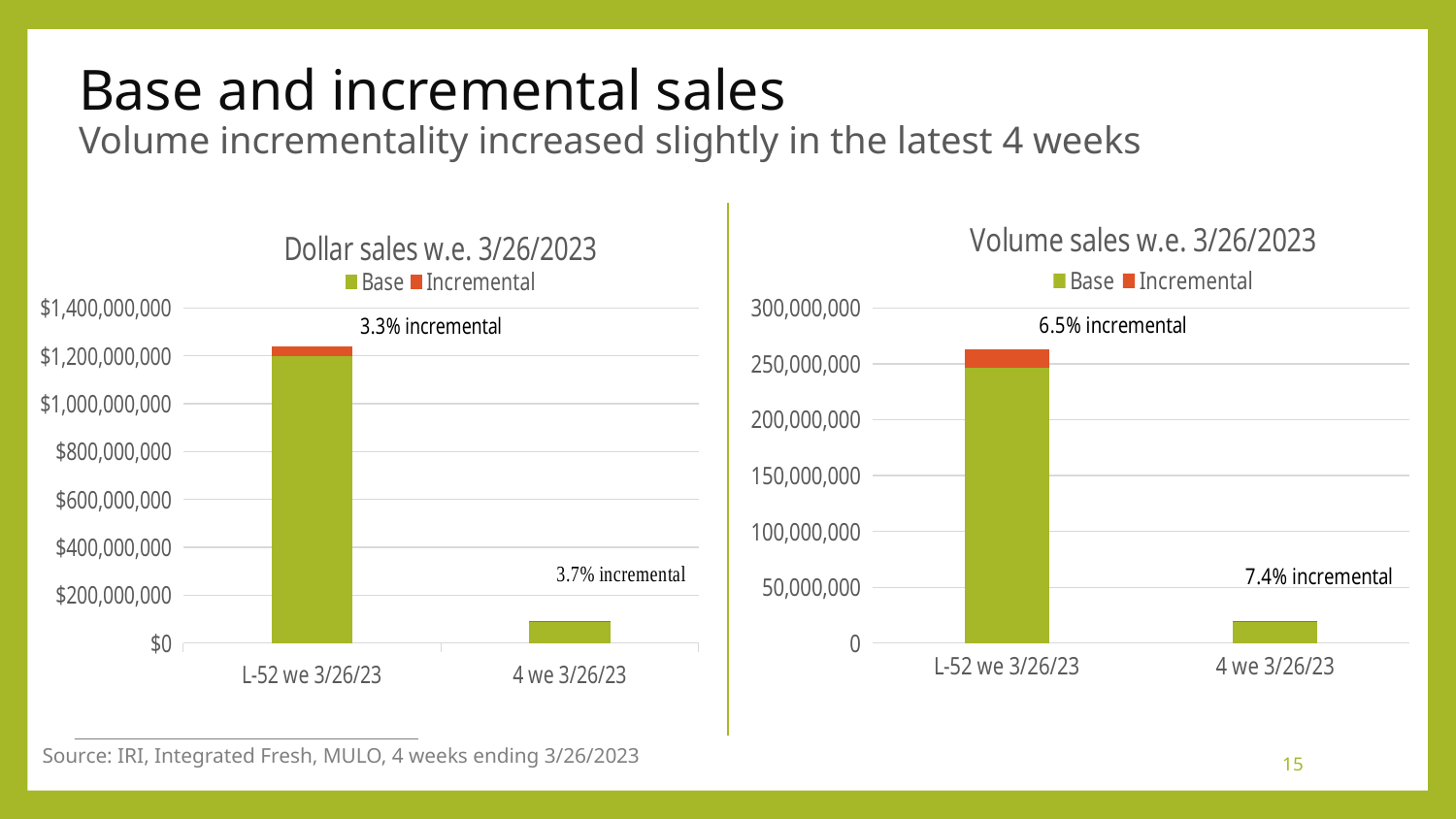
In the Volume sales w.e. 3/26/2023 chart, which category has the taller bar, L-52 we 3/26/23 or 4 we 3/26/23? L-52 we 3/26/23 How many categories are shown on the x axis of the Dollar sales w.e. 3/26/2023 chart? 2 In the Dollar sales w.e. 3/26/2023 chart, what incremental percentage is shown for L-52 we 3/26/23? 3.3% incremental What type of chart is the Volume sales w.e. 3/26/2023 chart? Stacked bar chart In the Dollar sales w.e. 3/26/2023 chart, what incremental percentage is shown for 4 we 3/26/23? 3.7% incremental In the Dollar sales w.e. 3/26/2023 chart, is the total bar for L-52 we 3/26/23 greater or less than $1,200,000,000? greater In the Volume sales w.e. 3/26/2023 chart, what incremental percentage is shown for L-52 we 3/26/23? 6.5% incremental In the Volume sales w.e. 3/26/2023 chart, is the total bar for L-52 we 3/26/23 greater or less than 250,000,000? greater In the Volume sales w.e. 3/26/2023 chart, is the total bar for 4 we 3/26/23 greater or less than 50,000,000? less In the Volume sales w.e. 3/26/2023 chart, what incremental percentage is shown for 4 we 3/26/23? 7.4% incremental How many series does the legend of the Dollar sales w.e. 3/26/2023 chart list? 2